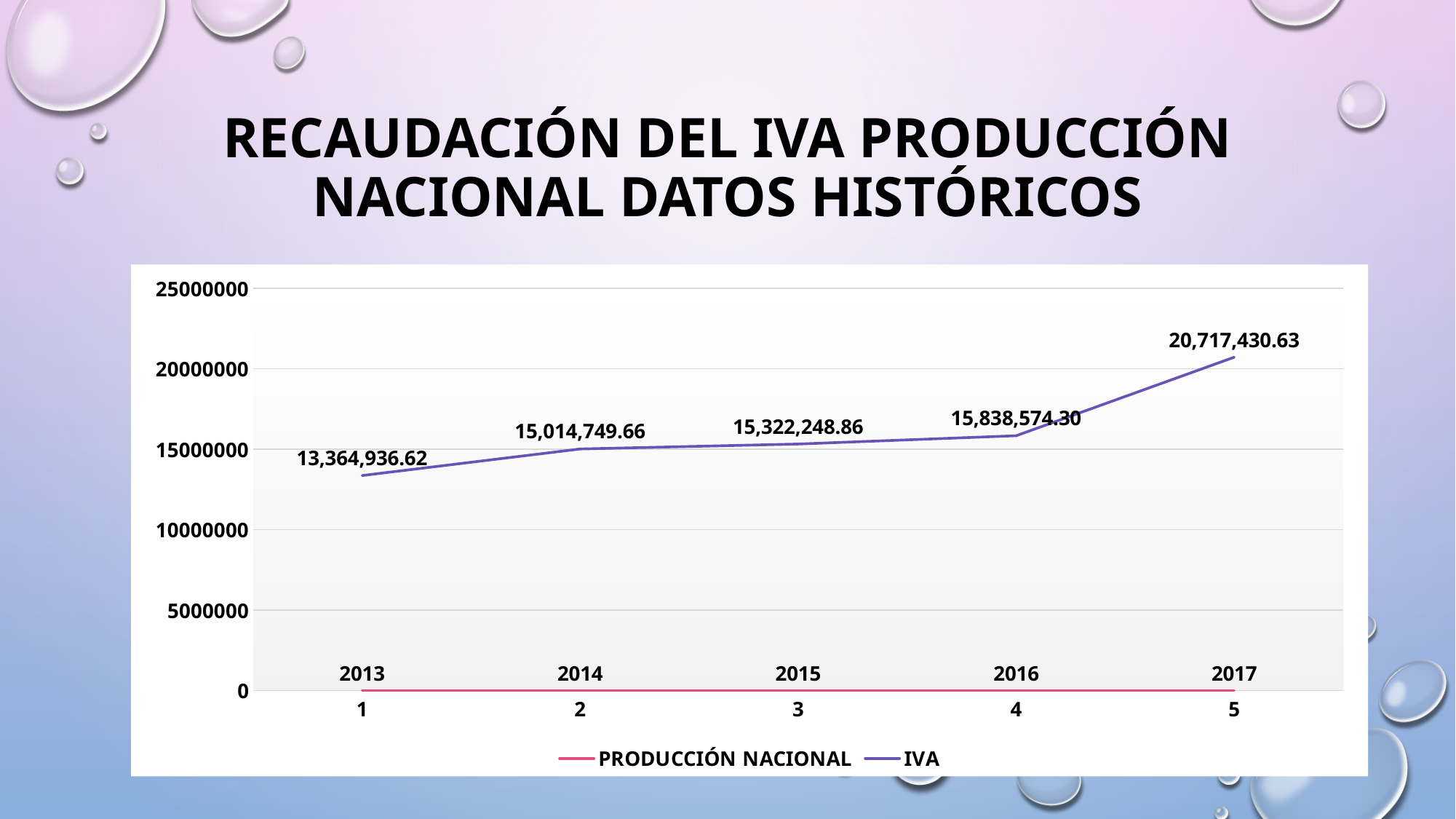
What is the IVA value at x-axis category 2 (the point labelled 2014)? 15,014,749.66 What is the difference between the IVA value at category 5 and the IVA value at category 4? 4,878,856.33 Does the IVA series rise or fall from category 1 to category 5? rise What are the two series named in the legend? PRODUCCIÓN NACIONAL and IVA What is the IVA value at x-axis category 5 (the point labelled 2017)? 20,717,430.63 At which x-axis category is the IVA value lowest? 1 At which x-axis category is the IVA value highest? 5 How many series does the legend list? 2 What is the IVA value at x-axis category 3 (the point labelled 2015)? 15,322,248.86 What is the IVA value at x-axis category 1 (the point labelled 2013)? 13,364,936.62 How many points are plotted along the x axis for the IVA series? 5 What type of chart is shown on the slide? line chart